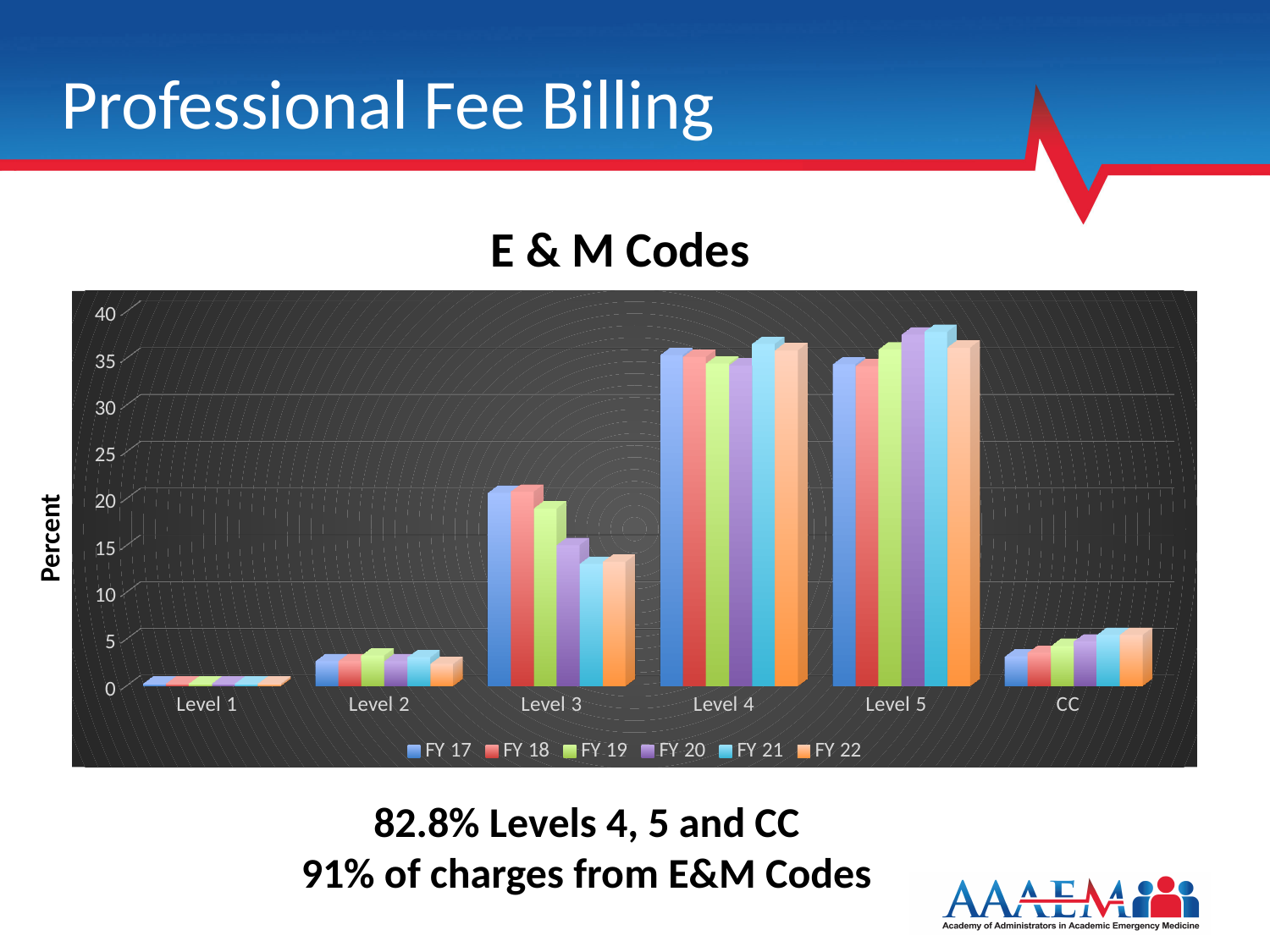
Is the value for Level 3 in FY 21 greater or less than 15? less Is the value for Level 5 in FY 21 greater or less than 35? greater What is the title of the chart? E & M Codes How many series does the legend list? 6 Is the value for CC in FY 17 greater or less than 5? less Which category has the lowest values across all fiscal years? Level 1 For Level 3, do the values rise or fall from FY 17 to FY 22? fall What is the label on the vertical axis of the chart? Percent What kind of chart is shown on the slide? bar chart How many categories are shown along the x axis? 6 Which is larger for FY 17: Level 2 or Level 3? Level 3